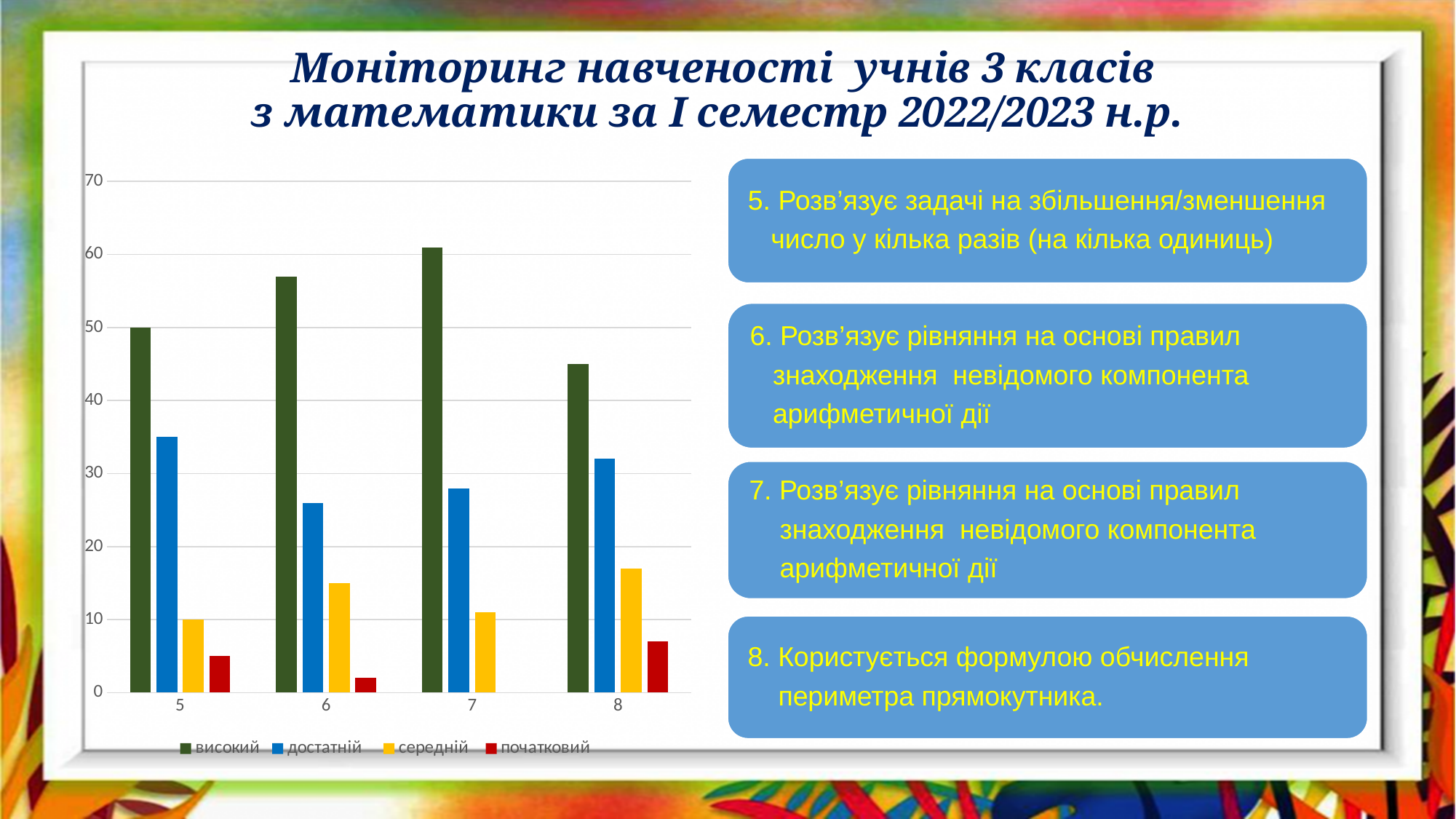
Which series is shown in dark green in the chart legend? високий Which series is shown in red in the chart legend? початковий Is the value for середній in category 8 greater or less than 20? less Which category has the highest value for the series високий? 7 Which category has the highest value for the series достатній? 5 Which category has the lowest value for the series високий? 8 How many series does the chart legend list? 4 Is the value for достатній in category 6 greater or less than 30? less How many categories are shown on the x axis of the chart? 4 Which is larger in category 8: the value for достатній or the value for середній? достатній Is the value for високий in category 6 greater or less than 50? greater What kind of chart is shown on the slide? bar chart